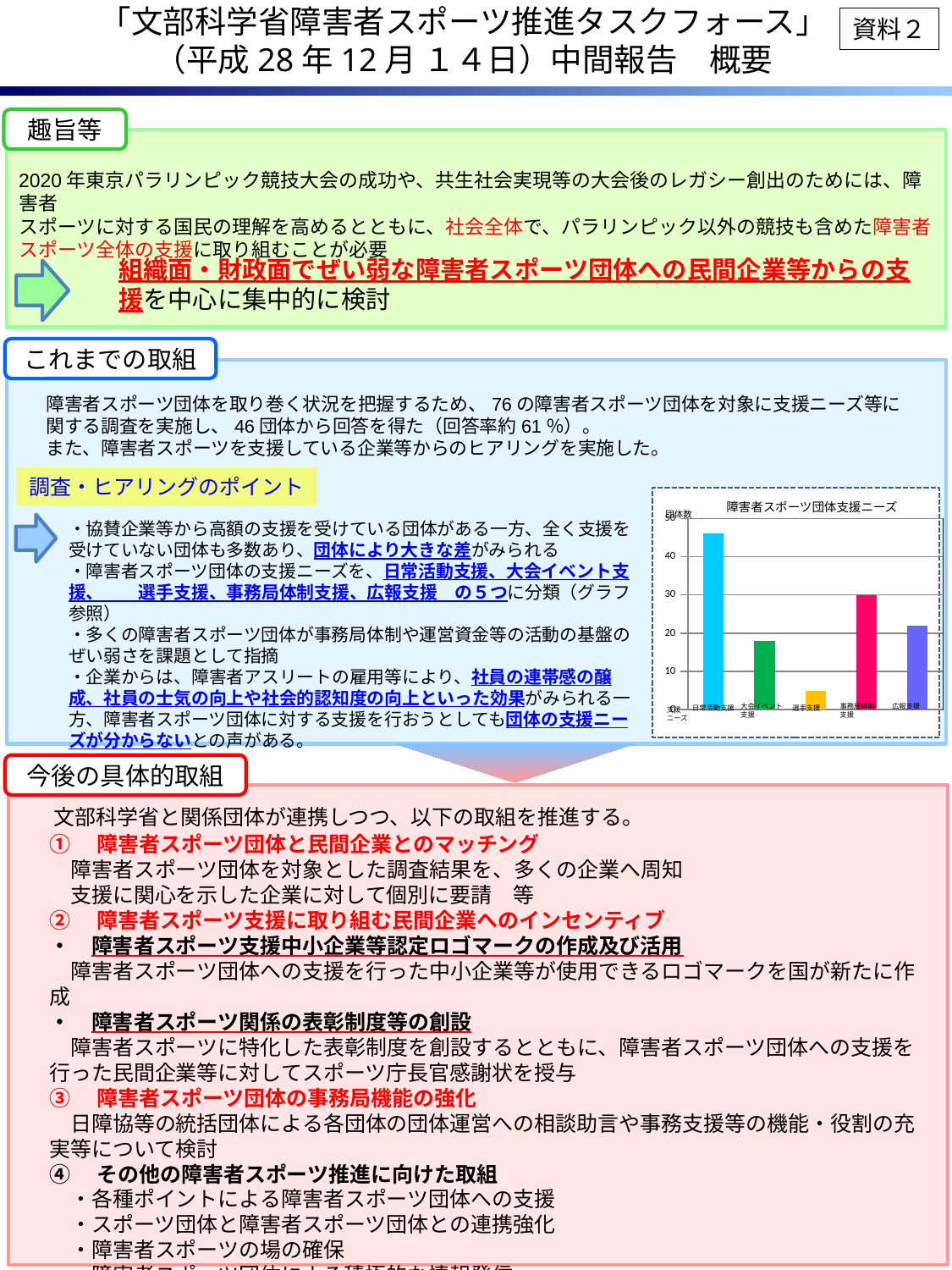
Is the value for 日常活動支援 greater or less than 40? greater Is the value for 大会イベント支援 greater or less than 20? less Which category has the lowest value in the chart 障害者スポーツ団体支援ニーズ? 選手支援 What kind of chart is shown on the slide? bar chart Is the value for 広報支援 greater or less than 30? less Which is larger, the value for 事務局体制支援 or the value for 広報支援? 事務局体制支援 What label is shown on the vertical axis of the chart? 団体数 What is the title of the chart on the slide? 障害者スポーツ団体支援ニーズ How many categories are shown in the chart 障害者スポーツ団体支援ニーズ? 5 Which category has the highest value in the chart 障害者スポーツ団体支援ニーズ? 日常活動支援